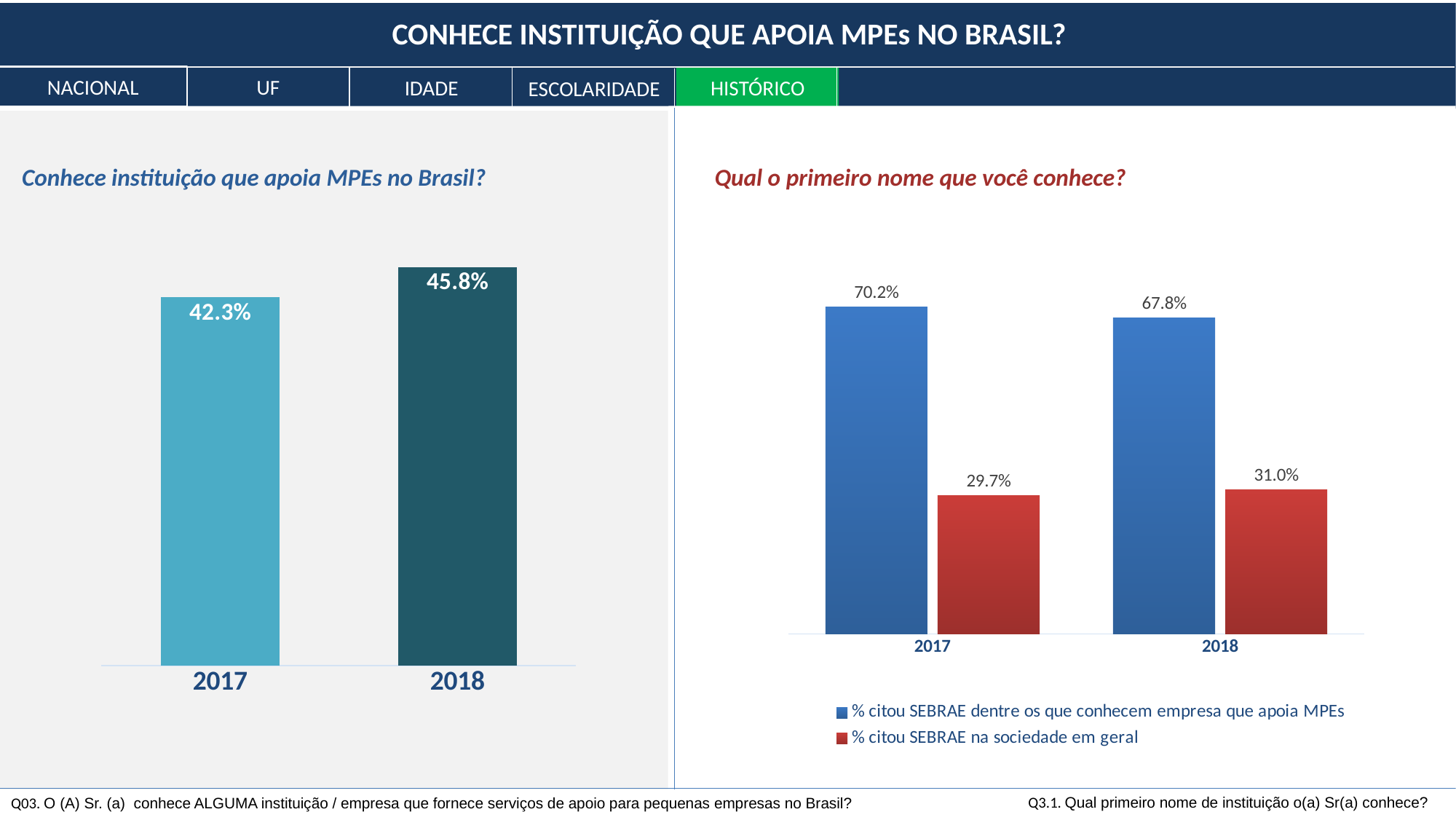
In the left chart 'Conhece instituição que apoia MPEs no Brasil?', by how many percentage points did the value change from 2017 to 2018? 3.5 percentage points In the right chart 'Qual o primeiro nome que você conhece?', what is the value for '% citou SEBRAE na sociedade em geral' in 2018? 31.0% What type of chart is the left chart 'Conhece instituição que apoia MPEs no Brasil?'? bar chart In the right chart 'Qual o primeiro nome que você conhece?', what is the value for '% citou SEBRAE dentre os que conhecem empresa que apoia MPEs' in 2017? 70.2% In the left chart 'Conhece instituição que apoia MPEs no Brasil?', how many years are shown? 2 In the left chart 'Conhece instituição que apoia MPEs no Brasil?', what is the value for 2017? 42.3% In the right chart 'Qual o primeiro nome que você conhece?', what is the difference between the two series in 2018? 36.8 percentage points In the right chart 'Qual o primeiro nome que você conhece?', which series is shown in red? % citou SEBRAE na sociedade em geral In the left chart 'Conhece instituição que apoia MPEs no Brasil?', what is the value for 2018? 45.8% In the left chart 'Conhece instituição que apoia MPEs no Brasil?', do the values rise or fall from 2017 to 2018? rise In the right chart 'Qual o primeiro nome que você conhece?', how many series does the legend list? 2 In the right chart 'Qual o primeiro nome que você conhece?', which year has the higher value for '% citou SEBRAE dentre os que conhecem empresa que apoia MPEs'? 2017